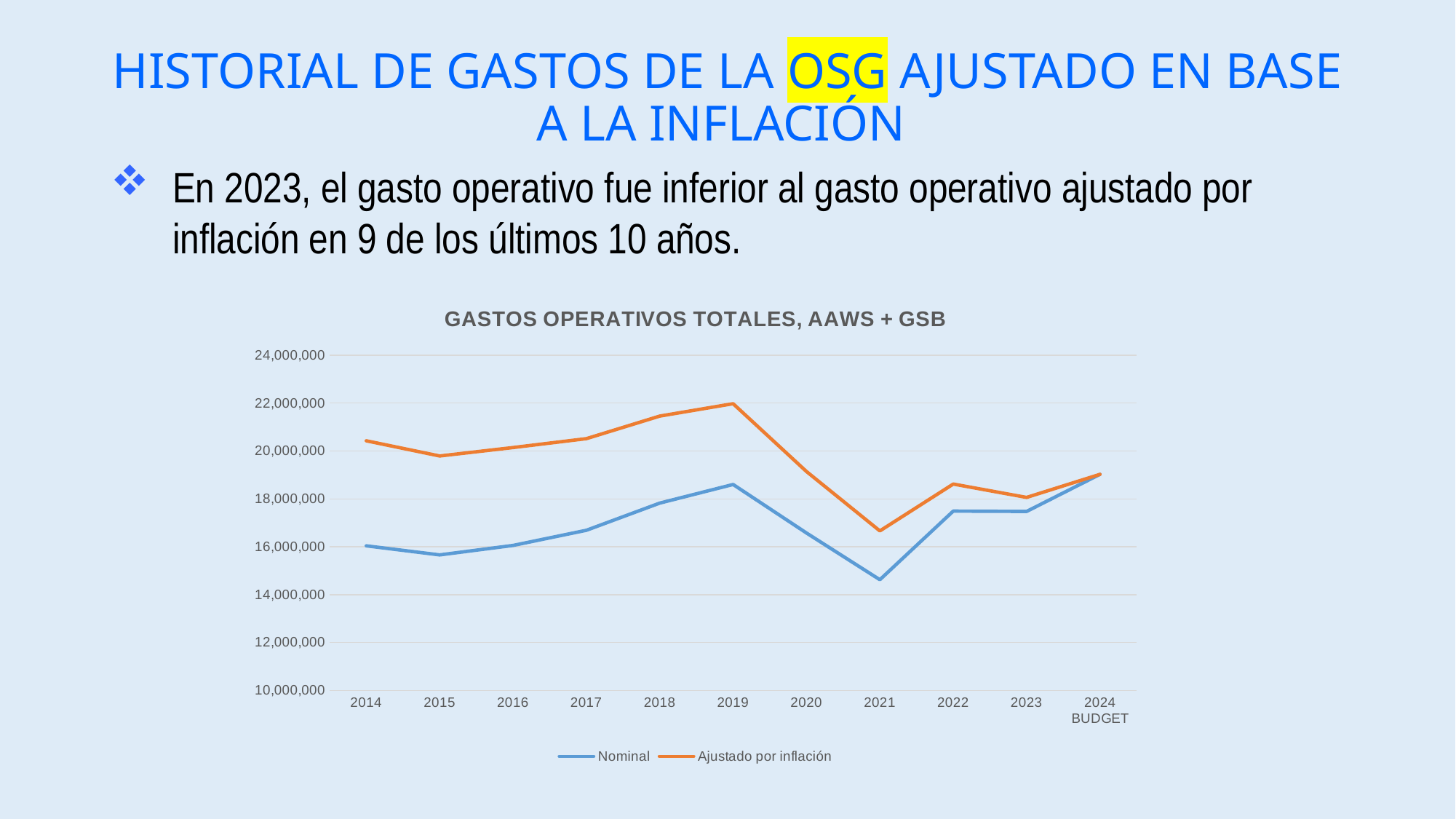
In which year does the Nominal series reach its lowest value? 2021 How many years (points) are shown along the x axis? 11 In which year does the Ajustado por inflación series reach its highest value? 2019 Does the Nominal series rise or fall from 2019 to 2021? fall What is the title of the chart? GASTOS OPERATIVOS TOTALES, AAWS + GSB In 2019, which series has the larger value, Nominal or Ajustado por inflación? Ajustado por inflación In which year does the Ajustado por inflación series reach its lowest value? 2021 How many series does the legend list? 2 What kind of chart is shown on the slide? line chart Is the Nominal value for 2014 greater or less than 14,000,000? greater Is the Nominal value for 2021 greater or less than 16,000,000? less Is the Ajustado por inflación value for 2019 greater or less than 20,000,000? greater